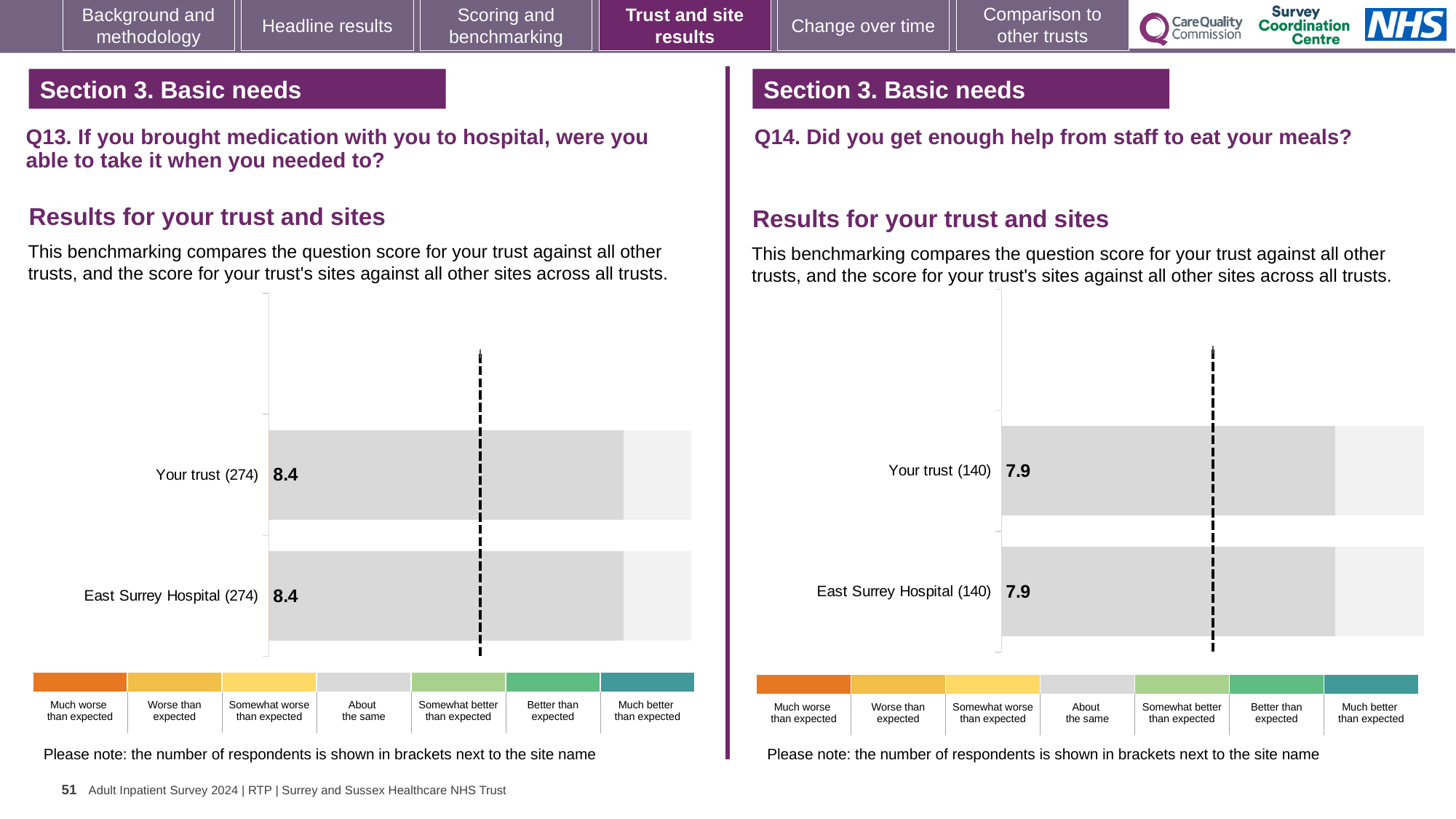
In the Q14 chart on the right, what is the difference between the Your trust score and the East Surrey Hospital score? 0 In the Q14 chart on the right, what is the score for Your trust? 7.9 What kind of chart is used for the Q13 results on the left? Bar chart In the Q13 chart on the left, what is the score for East Surrey Hospital? 8.4 In the Q13 chart on the left, what is the score for Your trust? 8.4 How many benchmark categories are shown in the colour key below the Q14 chart on the right? 7 How many bars are plotted in the Q13 chart on the left? 2 How many bars are plotted in the Q14 chart on the right? 2 In the Q13 chart on the left, how many respondents are shown in brackets next to Your trust? 274 In the Q14 chart on the right, how many respondents are shown in brackets next to East Surrey Hospital? 140 In the Q14 chart on the right, what is the score for East Surrey Hospital? 7.9 In the Q13 chart on the left, what is the difference between the Your trust score and the East Surrey Hospital score? 0